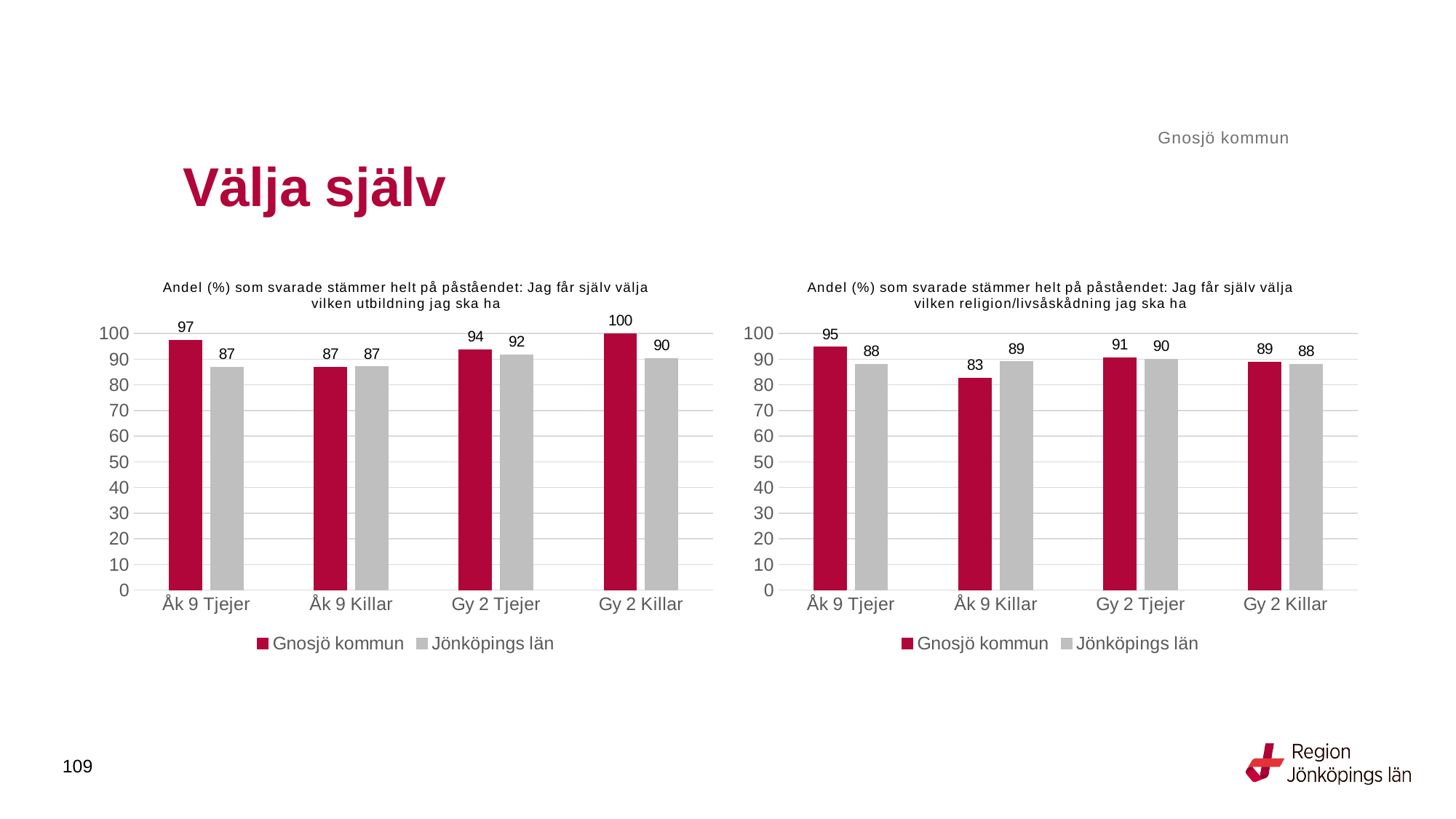
In the left chart (about choosing education), what is the difference between Gnosjö kommun and Jönköpings län for Åk 9 Tjejer? 10 How many categories are shown on the x axis of the left chart? 4 What kind of chart is the left chart? Bar chart In the right chart (about choosing religion), what is the value for Jönköpings län for Gy 2 Tjejer? 90 In the left chart (about choosing education), what is the value for Gnosjö kommun for Gy 2 Killar? 100 In the left chart (about choosing education), which category has the highest Gnosjö kommun value? Gy 2 Killar In the right chart (about choosing religion), which is larger for Åk 9 Tjejer: Gnosjö kommun or Jönköpings län? Gnosjö kommun In the right chart (about choosing religion), what is the difference between Jönköpings län and Gnosjö kommun for Åk 9 Killar? 6 In the left chart (about choosing education), what is the value for Jönköpings län for Gy 2 Tjejer? 92 In the right chart (about choosing religion), what is the value for Gnosjö kommun for Åk 9 Killar? 83 In the right chart (about choosing religion), which category has the lowest Gnosjö kommun value? Åk 9 Killar How many series does the legend of the right chart list? 2